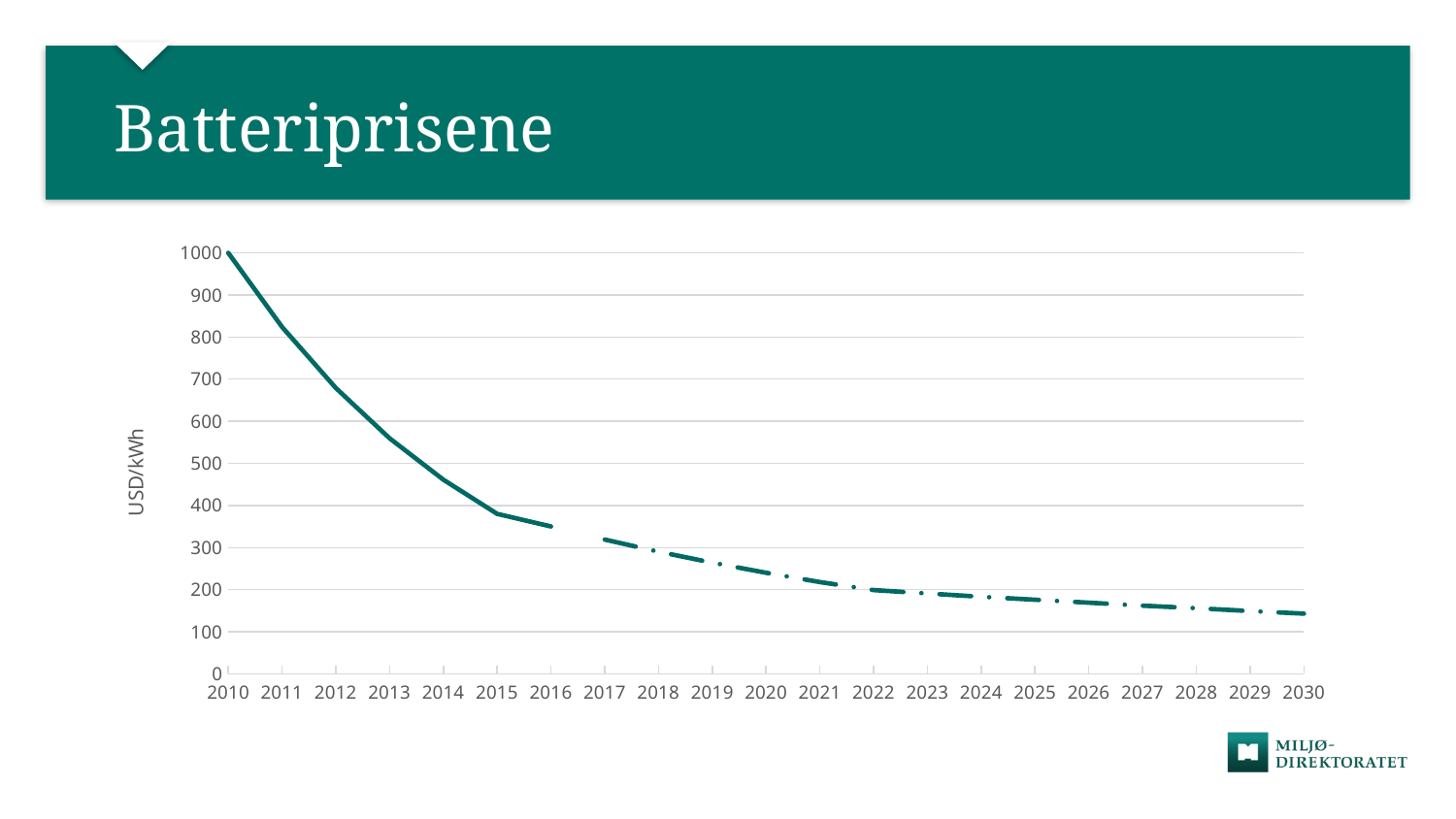
Do the values rise or fall from 2010 to 2030? fall Is the value for 2012 greater or less than 600? greater Is the value for 2015 greater or less than 400? less Which year has the larger value, 2013 or 2025? 2013 What kind of chart is shown on the slide? line chart How many years are labelled on the x axis? 21 Which year has the lowest value on the chart? 2030 What is the title of the chart on the slide? Batteriprisene Is the value for 2020 greater or less than 200? greater Which year has the highest value on the chart? 2010 What is the label on the vertical axis of the chart? USD/kWh